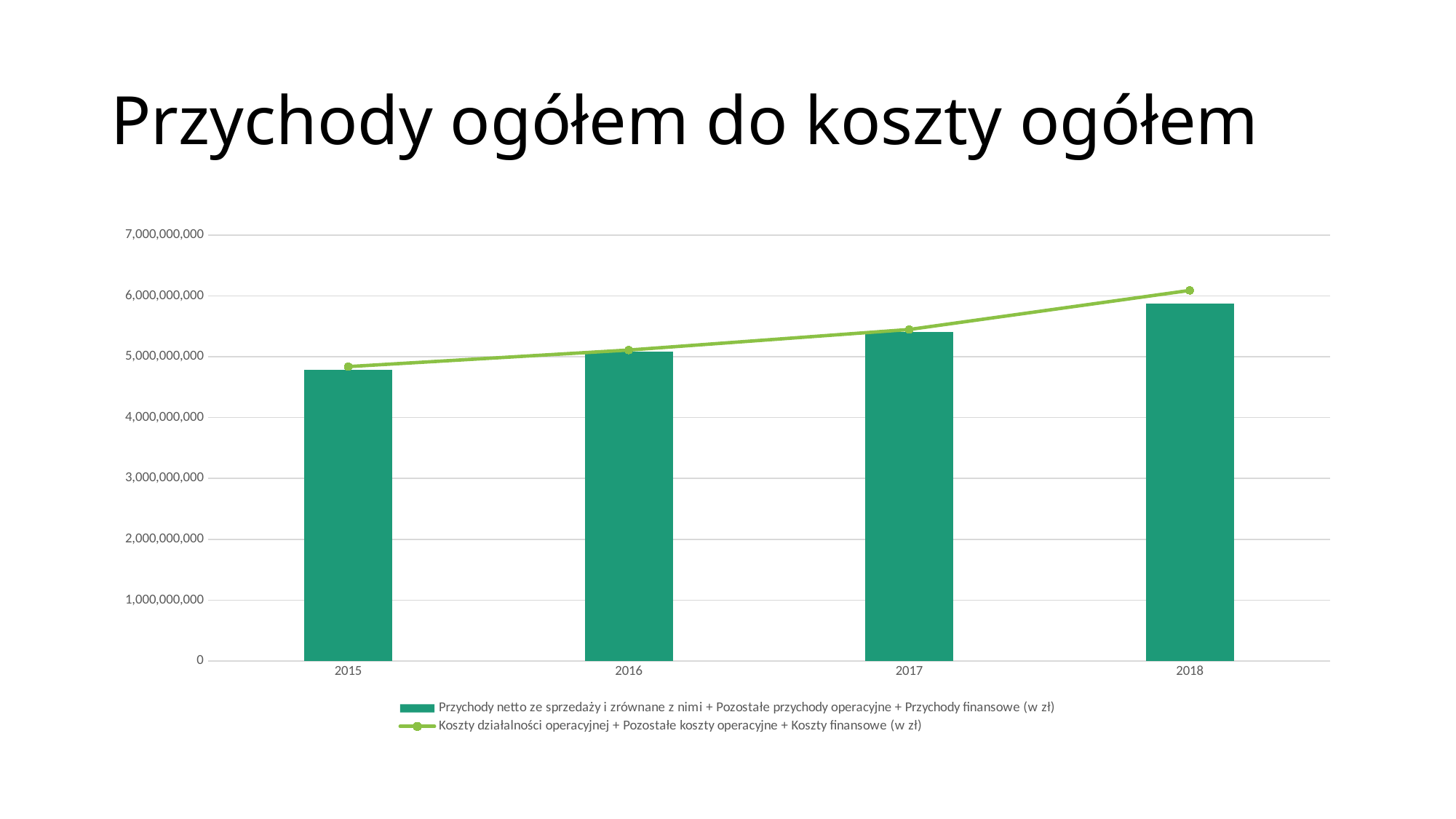
Which series is drawn as a line with markers in the chart? Koszty działalności operacyjnej + Pozostałe koszty operacyjne + Koszty finansowe (w zł) In 2018, which is larger: the Przychody bar or the Koszty line point? The Koszty line point What is the title of the chart on the slide? Przychody ogółem do koszty ogółem Which year has the highest bar for Przychody netto ze sprzedaży i zrównane z nimi + Pozostałe przychody operacyjne + Przychody finansowe? 2018 Is the bar value for 2015 greater or less than 5,000,000,000? less Is the bar value for 2017 greater or less than 5,000,000,000? greater How many years are shown on the x axis of the chart? 4 Do the values of the Koszty line rise or fall from 2015 to 2018? rise What kind of chart is shown on the slide? A bar chart combined with a line chart How many series does the chart's legend list? 2 Is the bar value for 2018 greater or less than 6,000,000,000? less Which year has the lowest bar for Przychody netto ze sprzedaży i zrównane z nimi + Pozostałe przychody operacyjne + Przychody finansowe? 2015